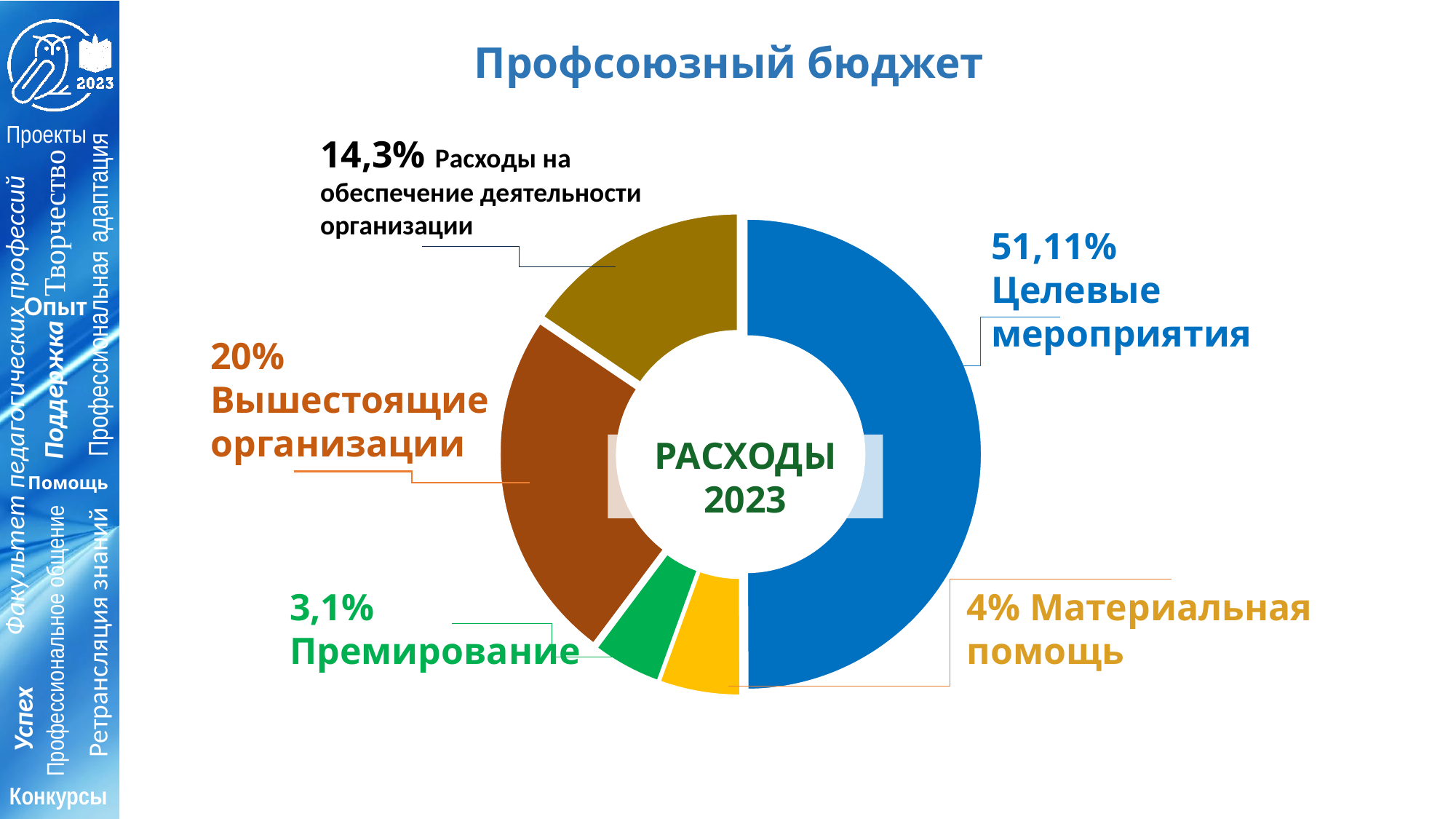
Which category has the smallest share of the chart? Премирование What percentage is shown for Премирование? 3,1% What text is written in the centre of the donut chart? РАСХОДЫ 2023 Which is larger: the share for Материальная помощь or the share for Премирование? Материальная помощь Which category has the largest share of the chart? Целевые мероприятия What kind of chart is shown on the slide? Pie chart (donut) What is the difference between the shares for Вышестоящие организации and Расходы на обеспечение деятельности организации? 5,7% What percentage is shown for Расходы на обеспечение деятельности организации? 14,3% What percentage is labelled for Вышестоящие организации? 20% How many slices does the chart have? 5 What percentage is shown for Материальная помощь? 4% What share of the budget goes to Целевые мероприятия? 51,11%